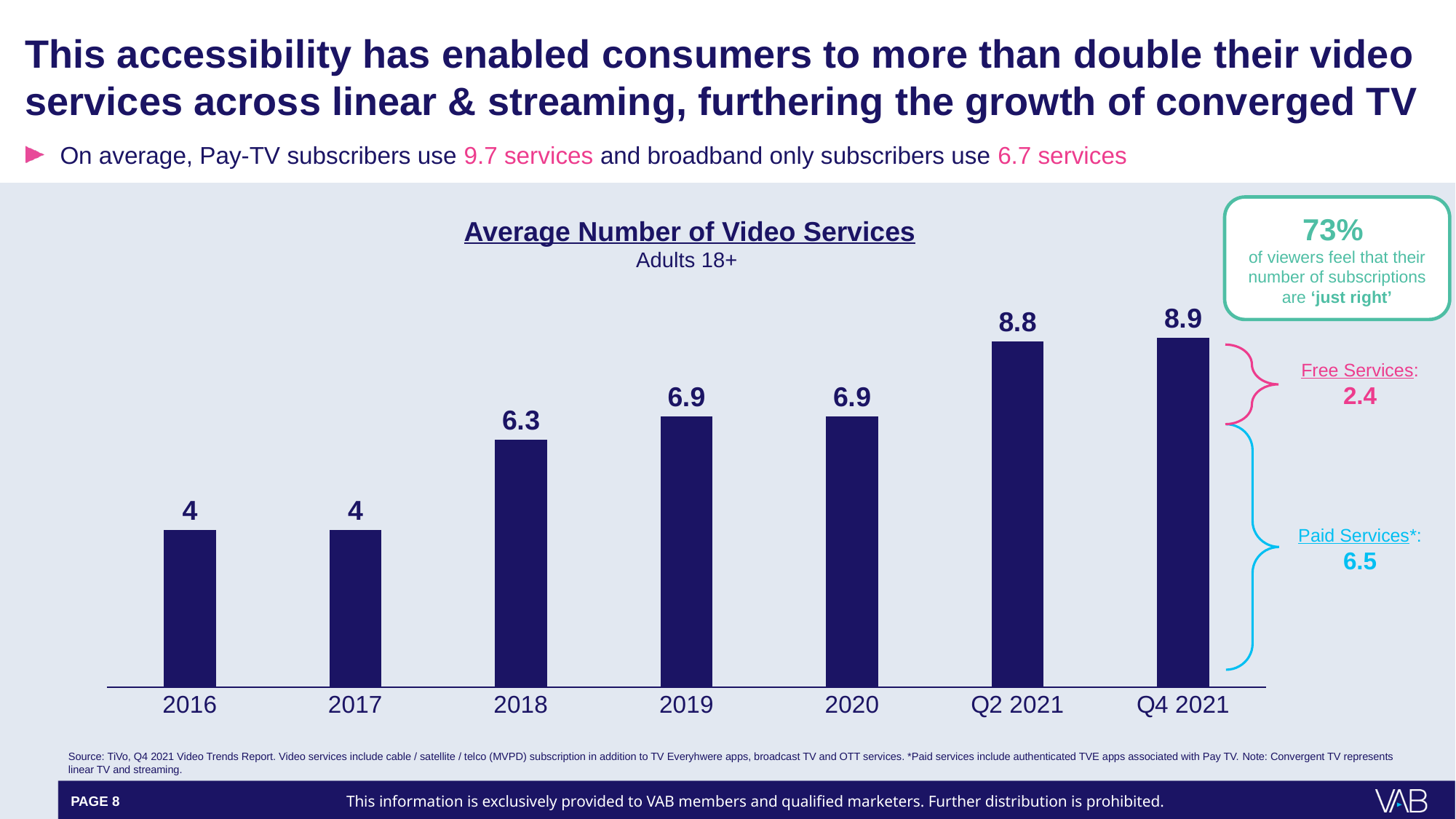
According to the annotation next to the Q4 2021 bar, how many of the services are Free Services? 2.4 What is the value shown for Q4 2021? 8.9 Which period has the highest average number of video services? Q4 2021 What is the difference between the values for 2018 and 2017? 2.3 Which is larger, the value for Q2 2021 or the value for 2020? Q2 2021 What is the difference between the values for Q4 2021 and 2016? 4.9 How many periods are shown on the x axis of the chart? 7 What is the title of the chart? Average Number of Video Services What is the average number of video services shown for 2018? 6.3 What kind of chart is used to show the average number of video services? Bar chart What is the value shown for 2016? 4 Do the values generally rise or fall from 2016 to Q4 2021? Rise